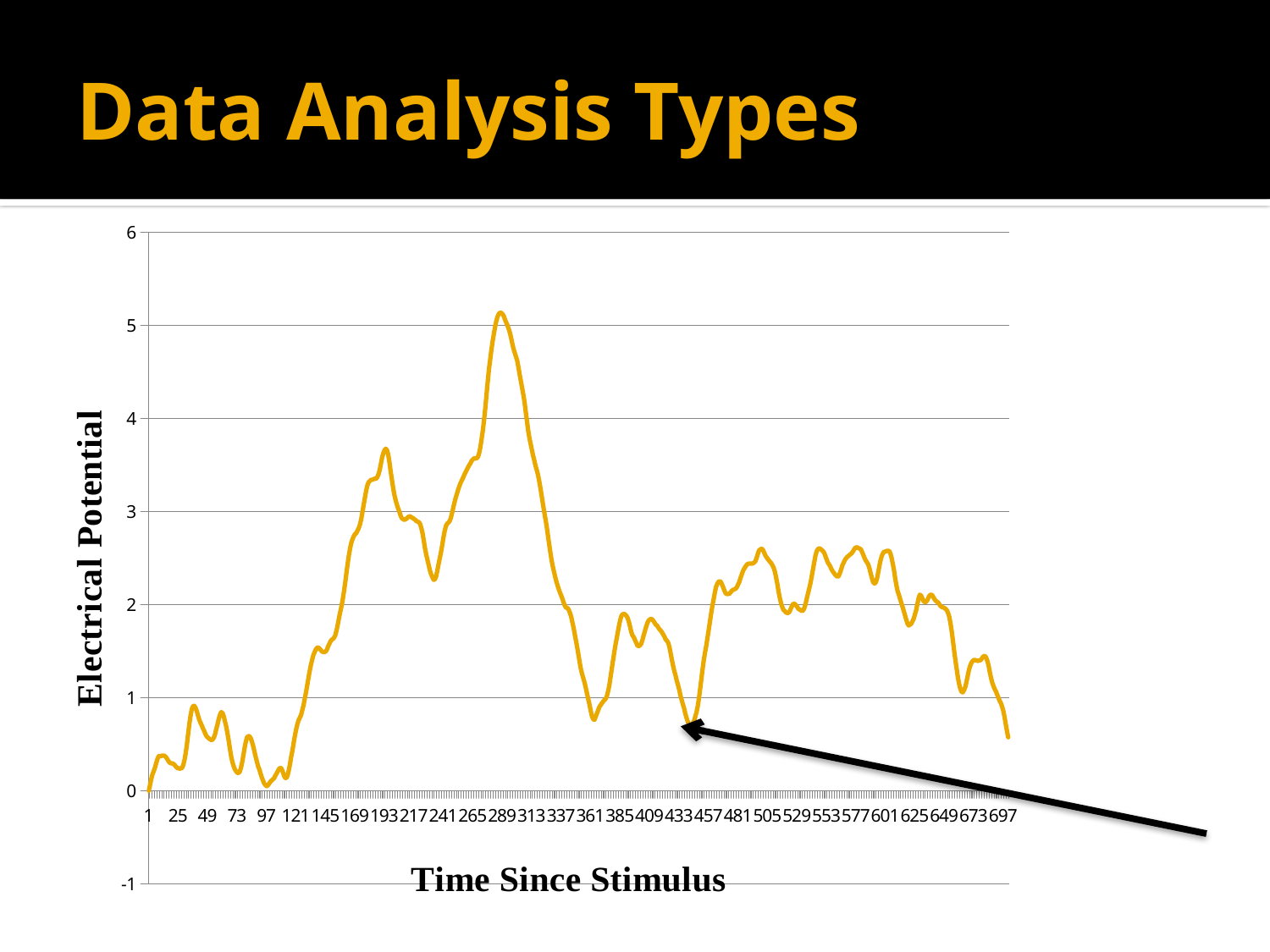
Is the value at x = 97 greater or less than 1? less Is the value at x = 193 greater or less than 3? greater What is the title of the horizontal axis? Time Since Stimulus What is the title of the vertical axis? Electrical Potential Is the value at x = 361 greater or less than 1? less Around which x-axis tick does the line reach its highest value? 289 What kind of chart is shown on the slide? line chart Between x = 145 and x = 289, does the line generally rise or fall? rise Between x = 289 and x = 361, does the line generally rise or fall? fall